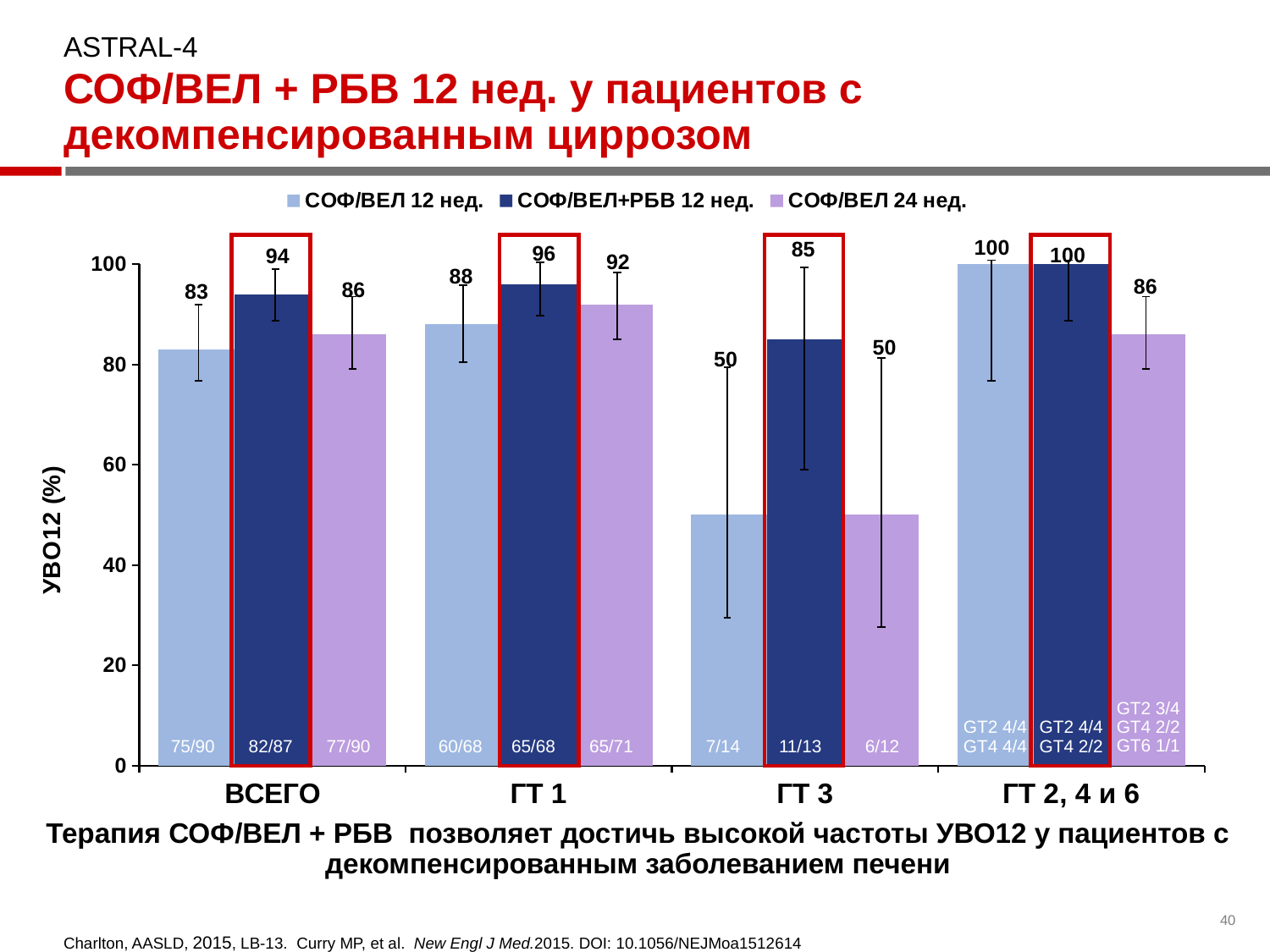
How many categories are shown on the x axis? 4 Which category has the lowest value for the СОФ/ВЕЛ 24 нед. series? ГТ 3 Which series has the lowest value in the ВСЕГО group? СОФ/ВЕЛ 12 нед. Which is larger in the ГТ 1 group: СОФ/ВЕЛ 12 нед. or СОФ/ВЕЛ+РБВ 12 нед.? СОФ/ВЕЛ+РБВ 12 нед. What kind of chart is shown on the slide? Bar chart What is the value for СОФ/ВЕЛ+РБВ 12 нед. in the ВСЕГО group? 94 What is the value for СОФ/ВЕЛ 24 нед. in the ГТ 1 group? 92 What is the value for СОФ/ВЕЛ 12 нед. in the ГТ 3 group? 50 What is the difference between the СОФ/ВЕЛ+РБВ 12 нед. and СОФ/ВЕЛ 12 нед. values in the ГТ 3 group? 35 What fraction is printed inside the СОФ/ВЕЛ+РБВ 12 нед. bar in the ВСЕГО group? 82/87 How many series does the legend list? 3 What is the label of the y axis? УВО12 (%)